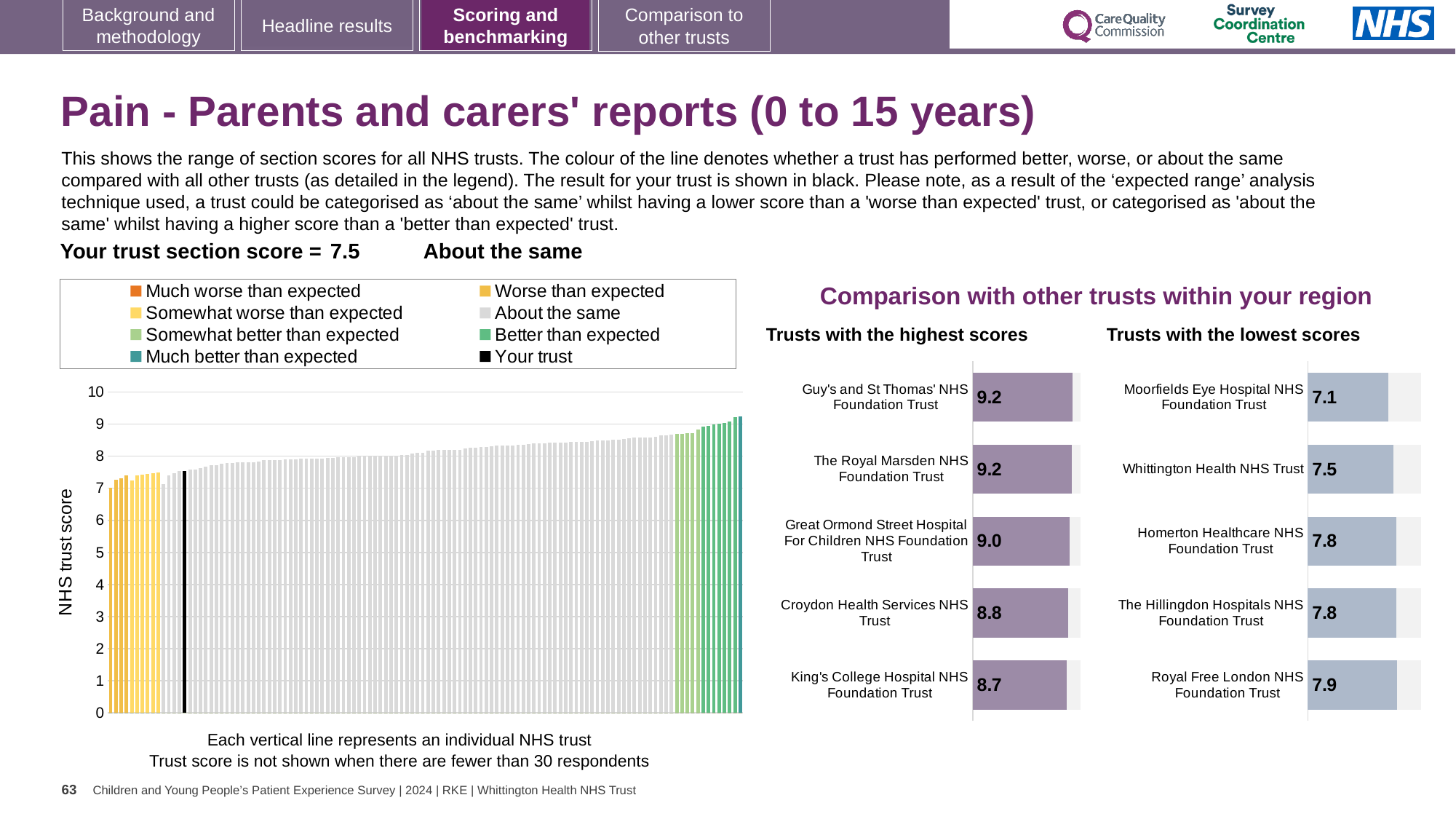
What kind of chart is the large chart on the left showing all NHS trusts? Bar chart In the 'Trusts with the highest scores' chart, what is the difference between the scores of Guy's and St Thomas' NHS Foundation Trust and King's College Hospital NHS Foundation Trust? 0.5 In the 'Trusts with the lowest scores' chart, what is the score for Moorfields Eye Hospital NHS Foundation Trust? 7.1 Which has a higher score: Croydon Health Services NHS Trust in the highest-scores chart or Homerton Healthcare NHS Foundation Trust in the lowest-scores chart? Croydon Health Services NHS Trust In the 'Trusts with the lowest scores' chart, what is the difference between the scores of Royal Free London NHS Foundation Trust and Moorfields Eye Hospital NHS Foundation Trust? 0.8 In the 'Trusts with the highest scores' chart, which trust has the lowest score shown? King's College Hospital NHS Foundation Trust In the large chart on the left, is the value for the highest-scoring trust greater or less than 9? greater In the 'Trusts with the lowest scores' chart, which trust has the lowest score? Moorfields Eye Hospital NHS Foundation Trust How many entries does the legend above the large chart on the left list? 8 How many trusts are listed in the 'Trusts with the lowest scores' chart? 5 In the 'Trusts with the highest scores' chart, what is the score for Guy's and St Thomas' NHS Foundation Trust? 9.2 In the 'Trusts with the highest scores' chart, what is the score for Croydon Health Services NHS Trust? 8.8